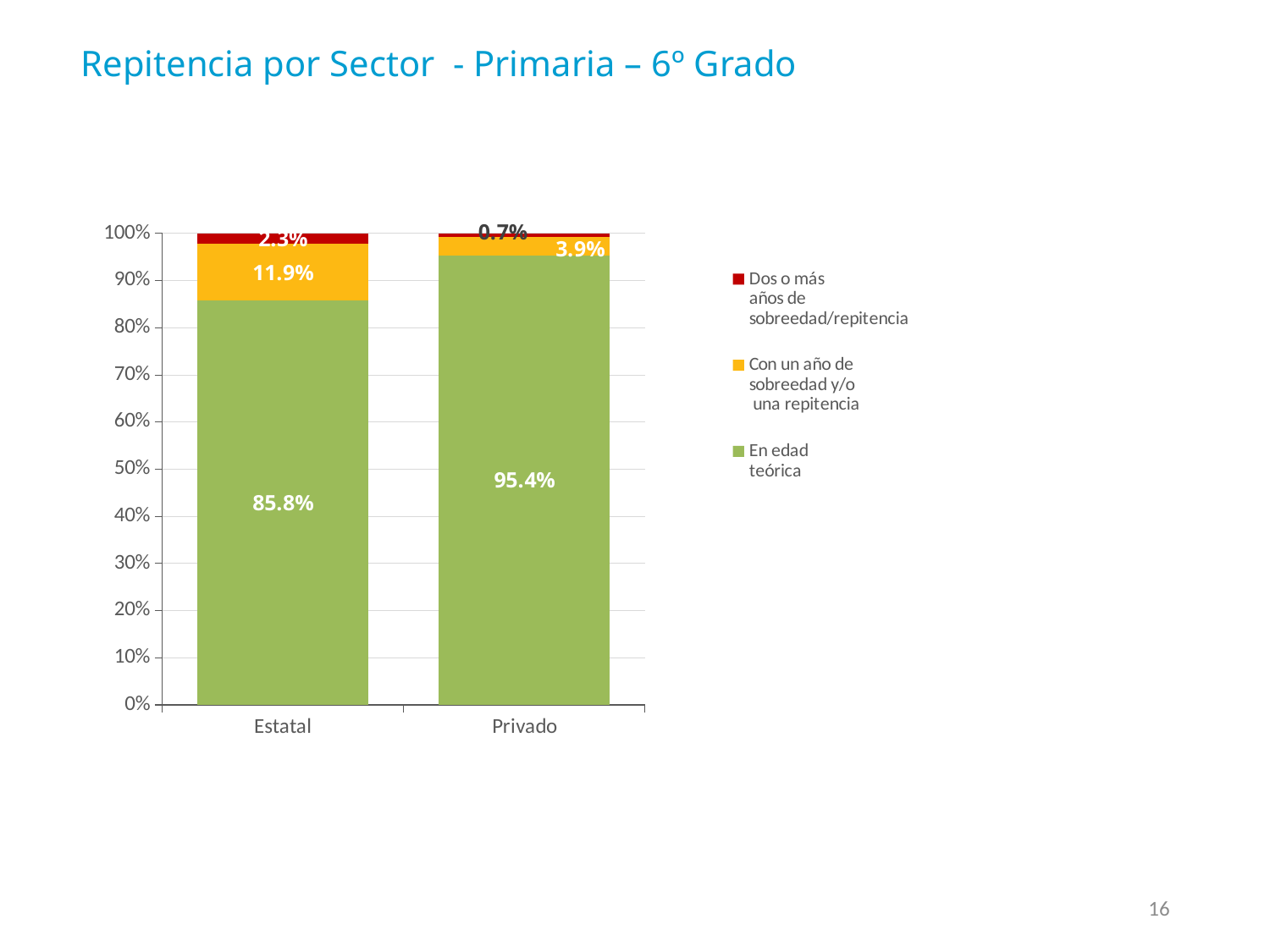
How many series does the legend list? 3 What is the value for "En edad teórica" in the Privado sector? 95.4% What is the title of the slide? Repitencia por Sector - Primaria – 6º Grado What is the value for "Con un año de sobreedad y/o una repitencia" in the Privado sector? 3.9% What kind of chart is shown on the slide? Stacked bar chart What is the value for "Dos o más años de sobreedad/repitencia" in the Privado sector? 0.7% What is the value for "Con un año de sobreedad y/o una repitencia" in the Estatal sector? 11.9% How many sectors (categories) are shown on the x axis? 2 What is the difference between the "Con un año de sobreedad y/o una repitencia" values for Estatal and Privado? 8.0% What is the difference between the "En edad teórica" values for Privado and Estatal? 9.6% What is the value for "En edad teórica" in the Estatal sector? 85.8% Which sector has the higher value for "En edad teórica"? Privado